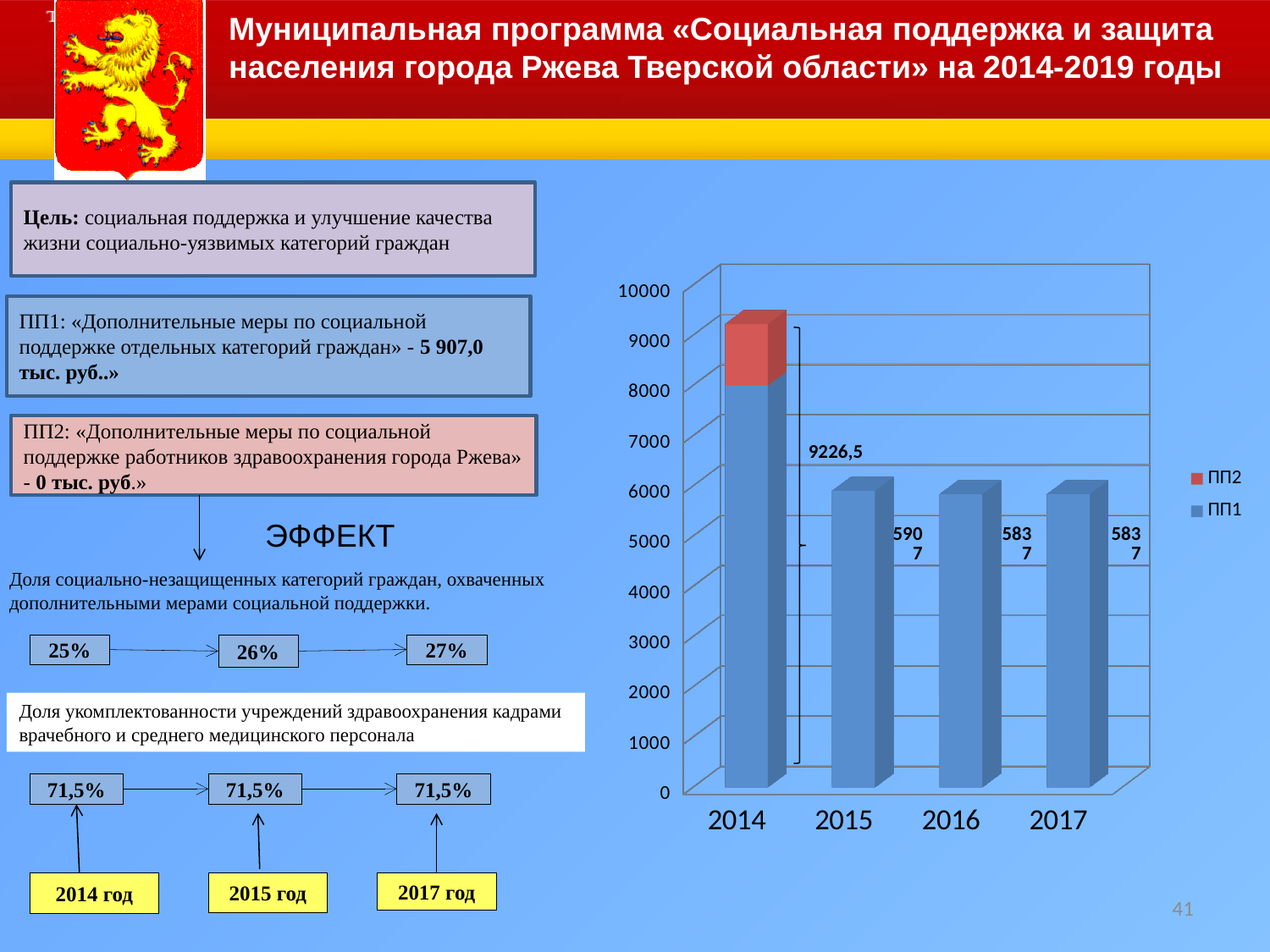
How many series does the chart legend list? 2 What is the difference between the labelled values for 2015 and 2016? 70 Do the bar values rise or fall from 2014 to 2017? fall What value is labelled on the bar for 2016? 5837 Which is larger, the labelled value for 2015 or for 2016? 2015 Which year has the tallest bar in the chart? 2014 Is the total height of the 2014 bar greater or less than 9000? greater What value is labelled on the bar for 2015? 5907 How many years are shown on the x axis of the chart? 4 What value is labelled on the bar for 2014? 9226,5 What kind of chart is shown on the slide? bar chart What colour represents the ПП2 series in the chart? red